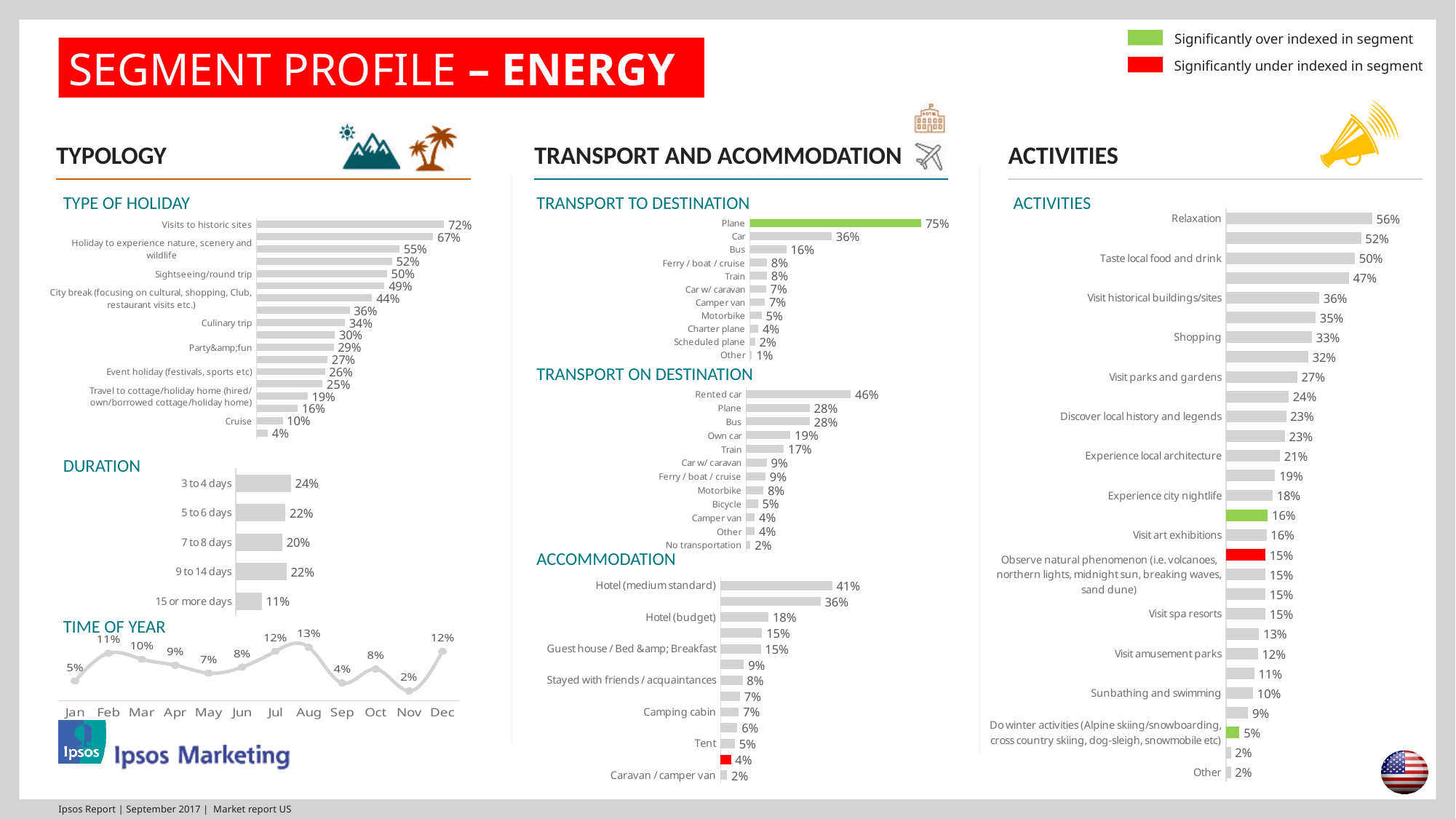
In the Activities chart, what is the value for Relaxation? 56% In the Duration chart, which duration category has the lowest value? 15 or more days In the Duration chart, what is the value for 3 to 4 days? 24% In the Transport to Destination chart, what is the value for Plane? 75% In the Transport on Destination chart, which is larger, Rented car or Own car? Rented car In the Time of Year chart, what is the value for Aug? 13% In the Time of Year chart, which month has the lowest value? Nov In the Type of Holiday chart, what is the value for Visits to historic sites? 72% What kind of chart is the Time of Year chart? Line chart In the Transport to Destination chart, what is the difference between Plane and Car? 39% How many categories are shown in the Transport on Destination chart? 12 In the Activities chart, what is the value for Do winter activities (Alpine skiing/snowboarding, cross country skiing, dog-sleigh, snowmobile etc)? 5%